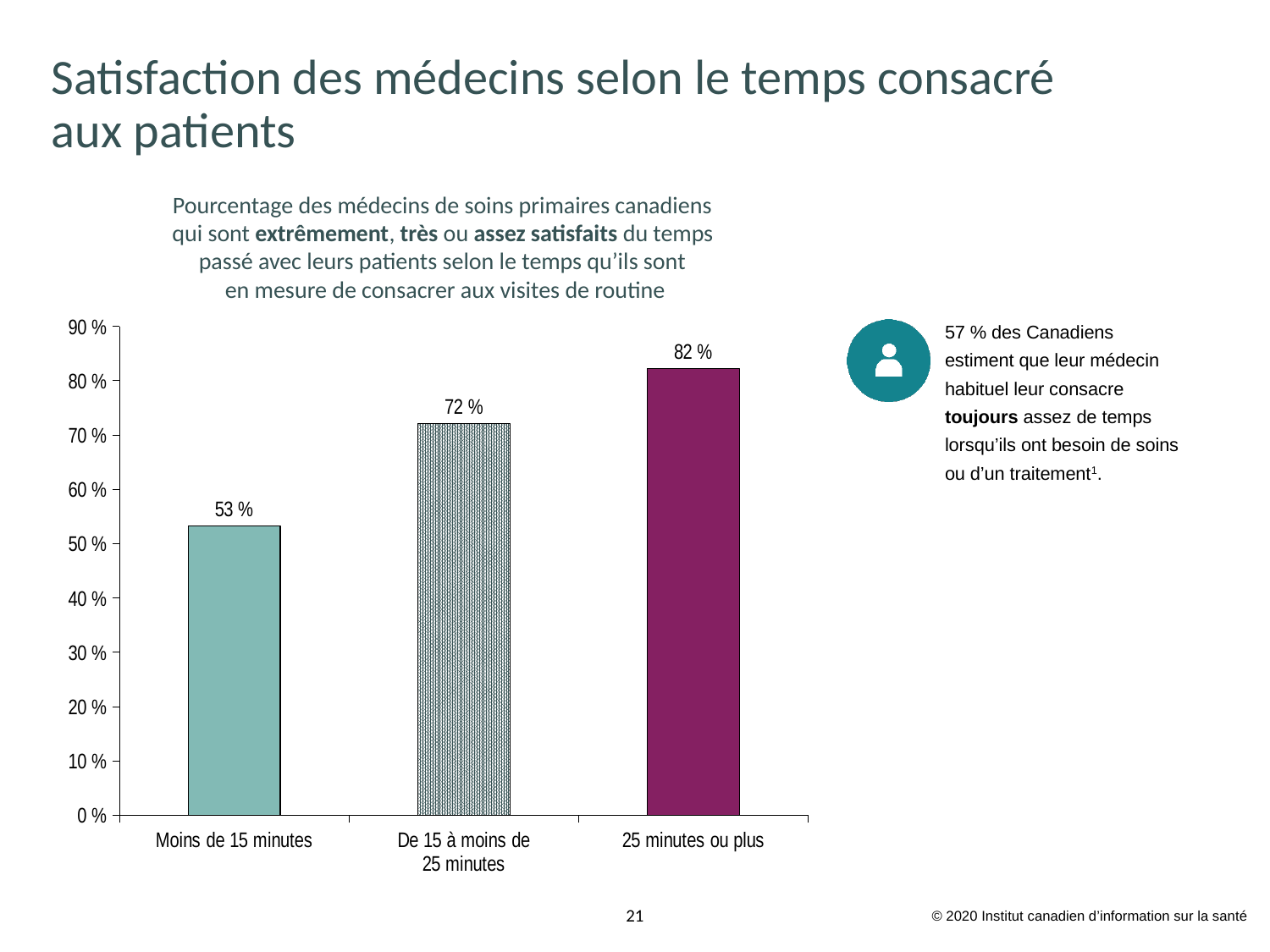
What is the difference between the values for "25 minutes ou plus" and "Moins de 15 minutes"? 29 % Which category has the highest value? 25 minutes ou plus What is the value for "Moins de 15 minutes"? 53 % What is the value for "De 15 à moins de 25 minutes"? 72 % Do the values rise or fall from left to right along the x axis? rise Which category has the lowest value? Moins de 15 minutes Is the value for "Moins de 15 minutes" greater or less than 60 %? less Which is larger, the value for "De 15 à moins de 25 minutes" or the value for "25 minutes ou plus"? 25 minutes ou plus How many categories are shown on the x axis? 3 What is the difference between the values for "De 15 à moins de 25 minutes" and "Moins de 15 minutes"? 19 % What is the value for "25 minutes ou plus"? 82 % What kind of chart is shown on the slide? bar chart